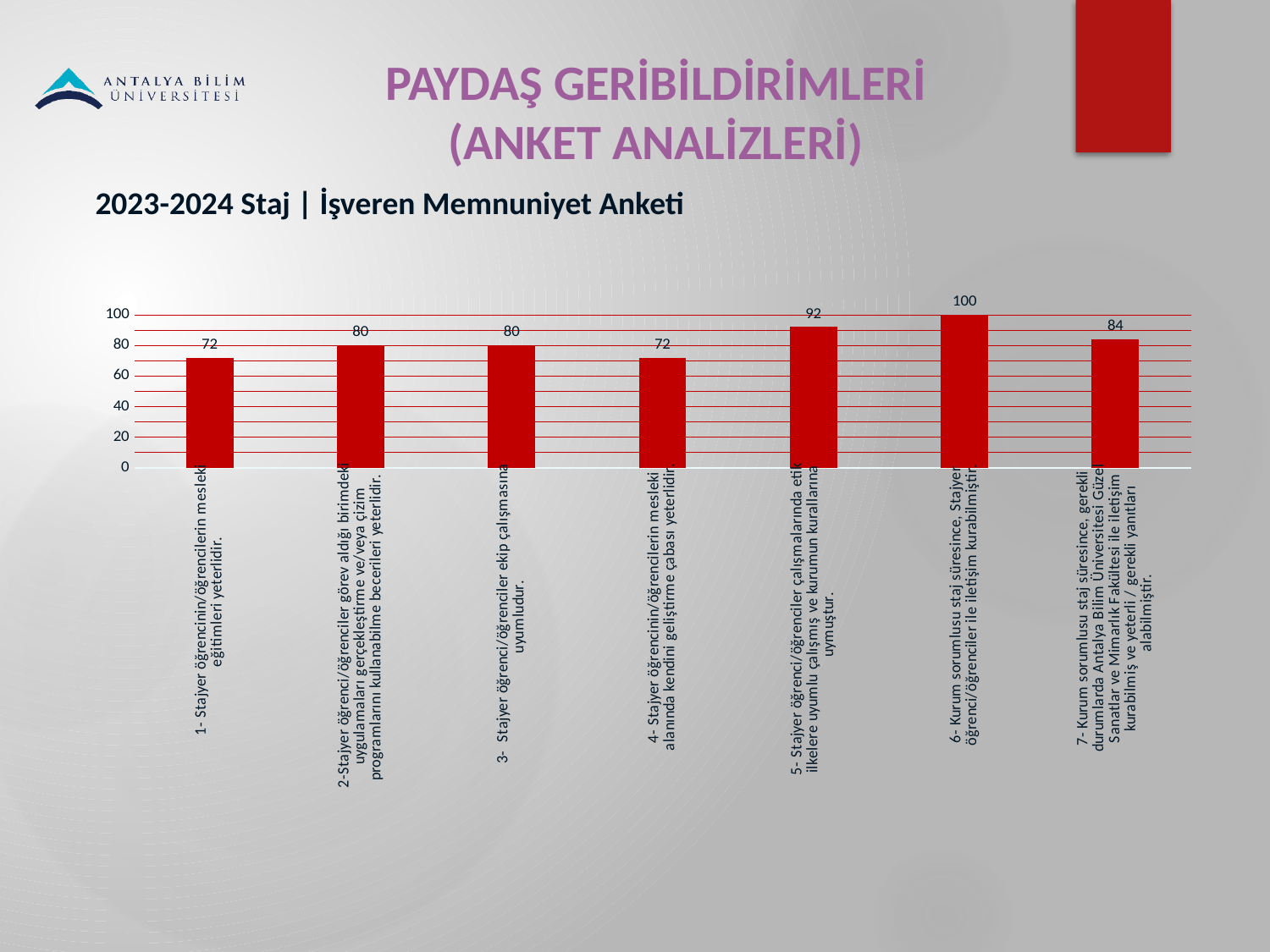
Which item has the highest value? 6- Kurum sorumlusu staj süresince, Stajyer öğrenci/öğrenciler ile iletişim kurabilmiştir. How many items (bars) are shown in the chart? 7 What kind of chart is shown on the slide? bar chart What is the value for item 3 (Stajyer öğrenci/öğrenciler ekip çalışmasına uyumludur)? 80 Which is larger, the value for item 2 or the value for item 4? item 2 What is the difference between the value for item 6 and the value for item 1? 28 What is the value for item 5 (Stajyer öğrenci/öğrenciler çalışmalarında etik ilkelere uyumlu çalışmış ve kurumun kurallarına uymuştur)? 92 What is the value for item 1 (Stajyer öğrencinin/öğrencilerin mesleki eğitimleri yeterlidir)? 72 What is the lowest value shown in the chart? 72 What is the subtitle above the chart? 2023-2024 Staj | İşveren Memnuniyet Anketi What is the difference between the value for item 5 and the value for item 7? 8 What is the value for item 7 (Kurum sorumlusu staj süresince, gerekli durumlarda Antalya Bilim Üniversitesi Güzel Sanatlar ve Mimarlık Fakültesi ile iletişim kurabilmiş ve yeterli / gerekli yanıtları alabilmiştir)? 84